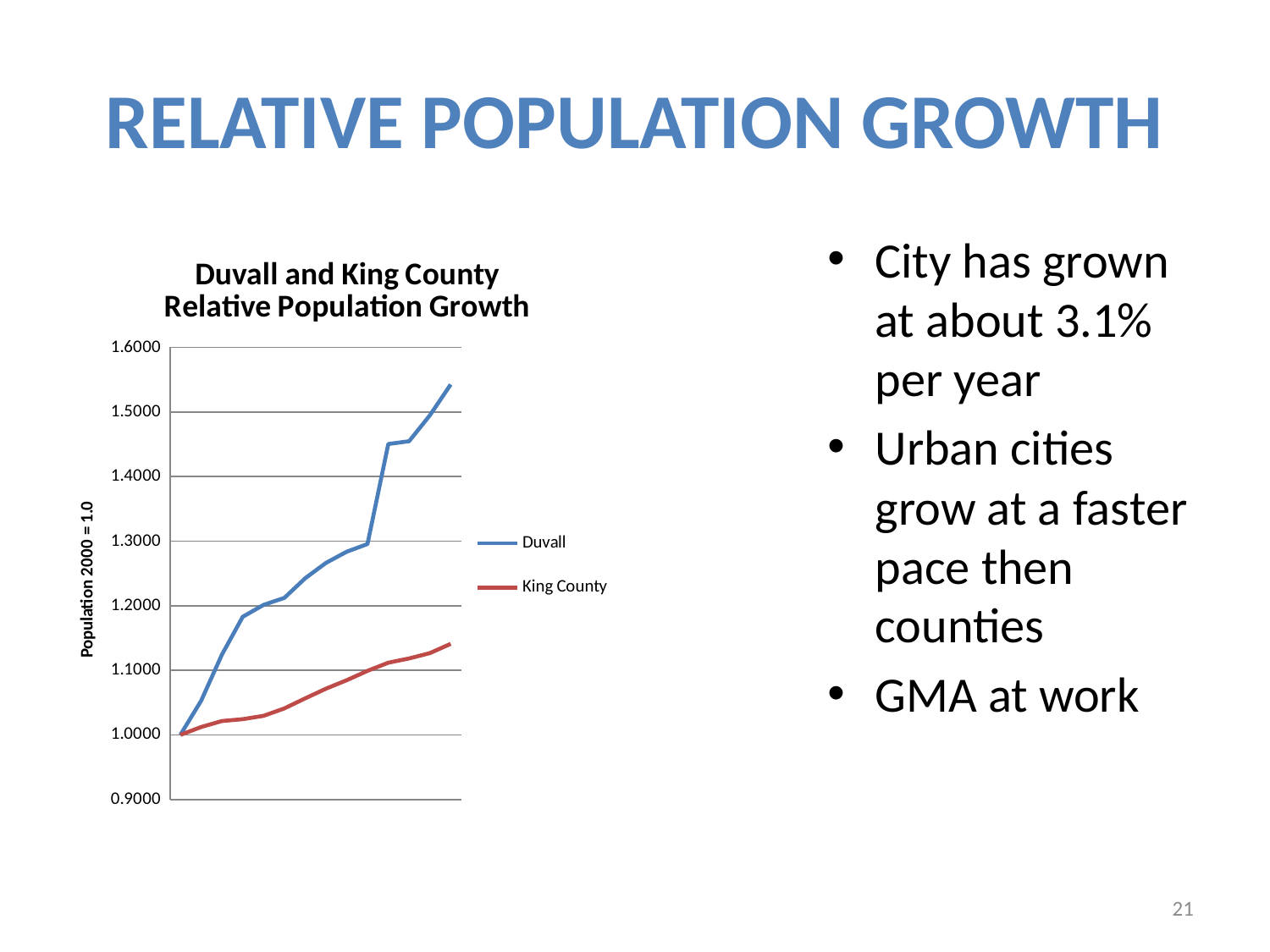
Is the final value of the Duvall line greater or less than 1.5000? greater Which series ends at a higher value at the right end of the chart, Duvall or King County? Duvall How many series does the chart's legend list? 2 Does the King County line rise or fall along the x axis? rise Does the Duvall line rise or fall along the x axis? rise Is the final value of the King County line greater or less than 1.1000? greater What is the title of the chart? Duvall and King County Relative Population Growth Is the final value of the King County line greater or less than 1.2000? less At what value do both the Duvall and King County lines start at the left of the chart? 1.0000 What are the two series named in the chart's legend? Duvall and King County What is the label on the chart's vertical axis? Population 2000 = 1.0 What kind of chart is shown on the slide? line chart